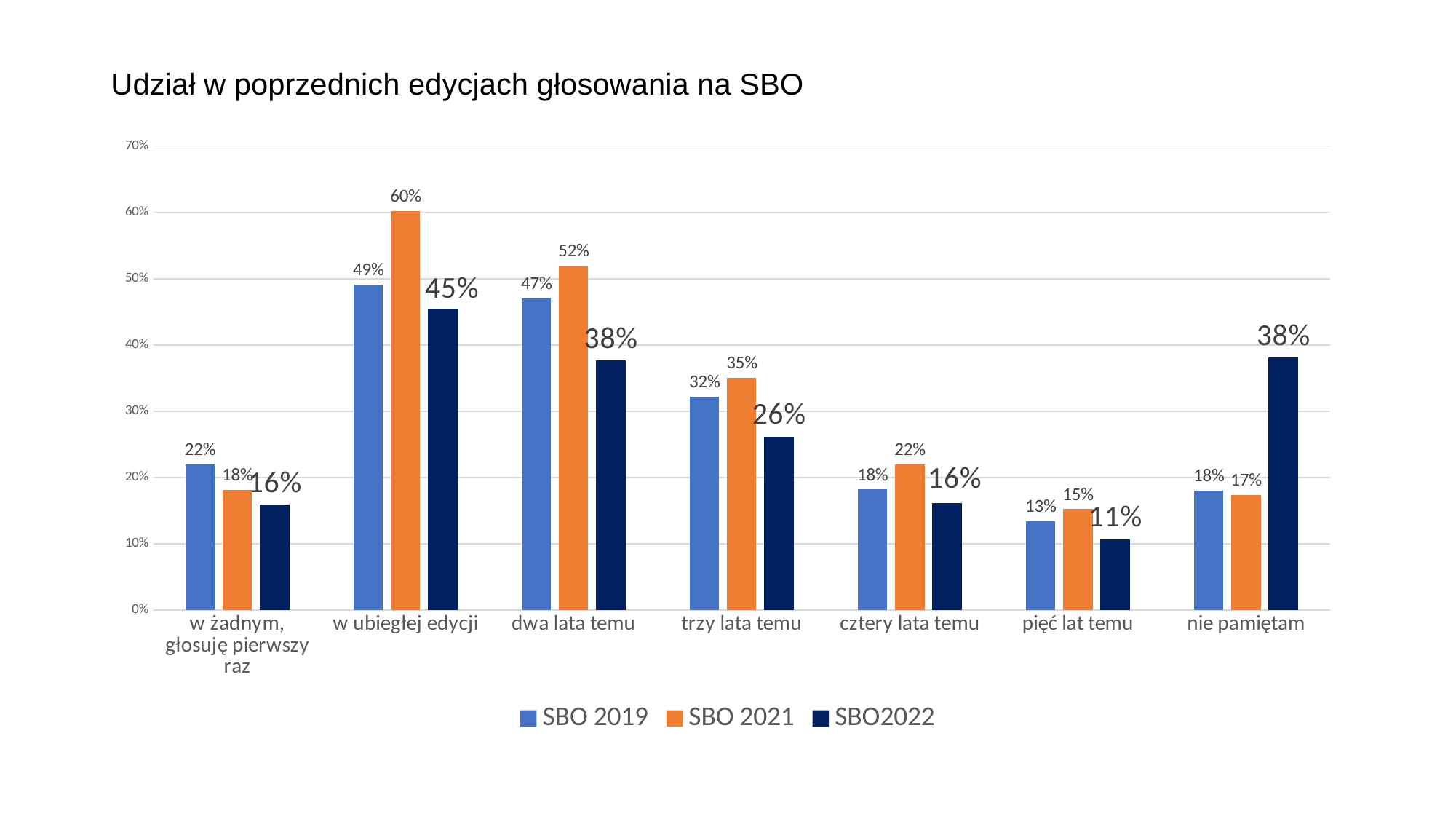
Which category has the highest value for the SBO 2021 series? w ubiegłej edycji What is the title of the chart? Udział w poprzednich edycjach głosowania na SBO What is the value for SBO 2019 in the category "trzy lata temu"? 32% What is the difference between the SBO 2021 and SBO 2019 values for "w ubiegłej edycji"? 11% How many categories are shown on the x axis? 7 Which is larger for "nie pamiętam": the SBO 2019 value or the SBO2022 value? SBO2022 What kind of chart is shown on the slide? bar chart How many series does the legend list? 3 What is the value for SBO 2021 in the category "w ubiegłej edycji"? 60% Which category has the lowest value for the SBO2022 series? pięć lat temu What is the value for SBO2022 in the category "nie pamiętam"? 38% Which series is shown in orange? SBO 2021